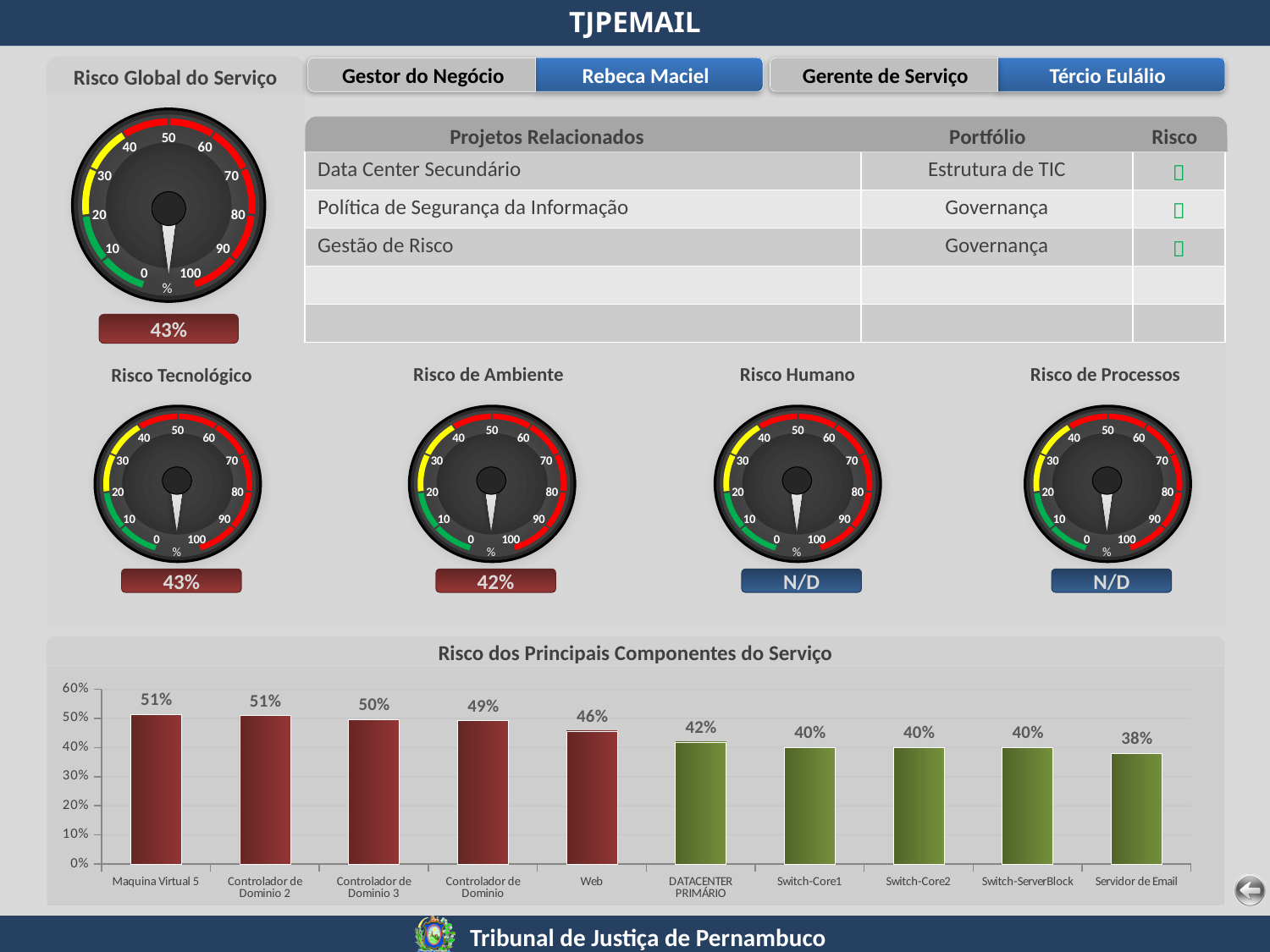
In the chart 'Risco dos Principais Componentes do Serviço', is the value for Switch-Core2 greater or less than 50%? less What kind of chart is 'Risco dos Principais Componentes do Serviço'? Bar chart In the chart 'Risco dos Principais Componentes do Serviço', which is larger, Controlador de Dominio 3 or Switch-Core1? Controlador de Dominio 3 In the chart 'Risco dos Principais Componentes do Serviço', what is the difference between Maquina Virtual 5 and Servidor de Email? 13% What value is shown below the 'Risco de Ambiente' gauge? 42% In the chart 'Risco dos Principais Componentes do Serviço', what is the value for Servidor de Email? 38% In the chart 'Risco dos Principais Componentes do Serviço', how many components are plotted? 10 In the chart 'Risco dos Principais Componentes do Serviço', which component has the lowest value? Servidor de Email What value is shown below the 'Risco Humano' gauge? N/D In the chart 'Risco dos Principais Componentes do Serviço', what is the value for DATACENTER PRIMÁRIO? 42% In the chart 'Risco dos Principais Componentes do Serviço', what is the value for Web? 46% In the chart 'Risco dos Principais Componentes do Serviço', do the values rise or fall from left to right? Fall